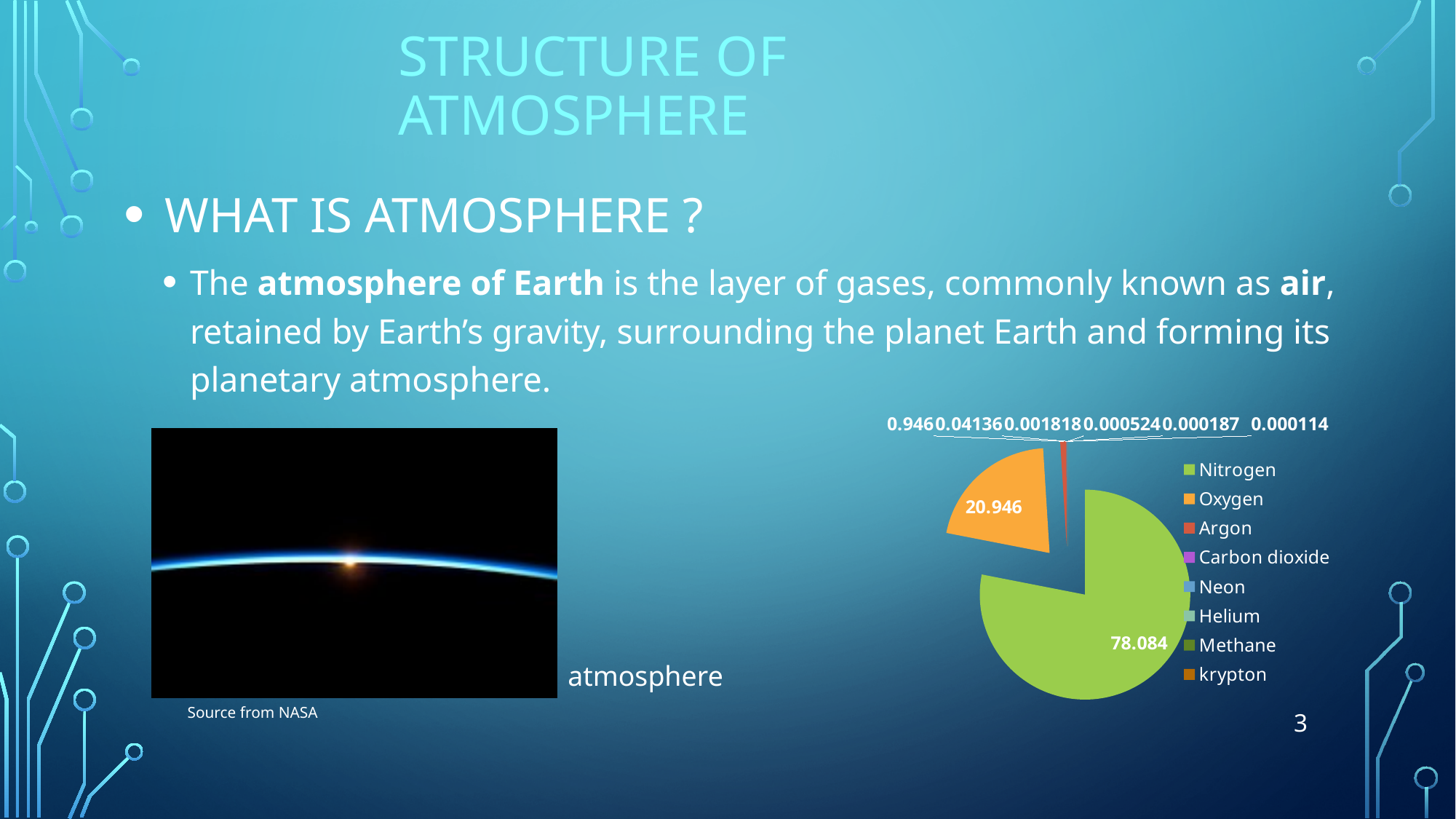
What is the difference between the Nitrogen and Oxygen values in the pie chart? 57.138 Which gas has the smallest value in the pie chart? krypton What is the value shown for Argon in the pie chart? 0.946 Which gas is listed last in the pie chart's legend? krypton What is the value shown for Oxygen in the pie chart? 20.946 Which is larger in the pie chart, Nitrogen or Oxygen? Nitrogen What colour is the Oxygen slice in the pie chart? orange What kind of chart is shown on the slide? pie chart What is the value shown for Nitrogen in the pie chart? 78.084 Which gas has the largest slice in the pie chart? Nitrogen How many gases are listed in the pie chart's legend? 8